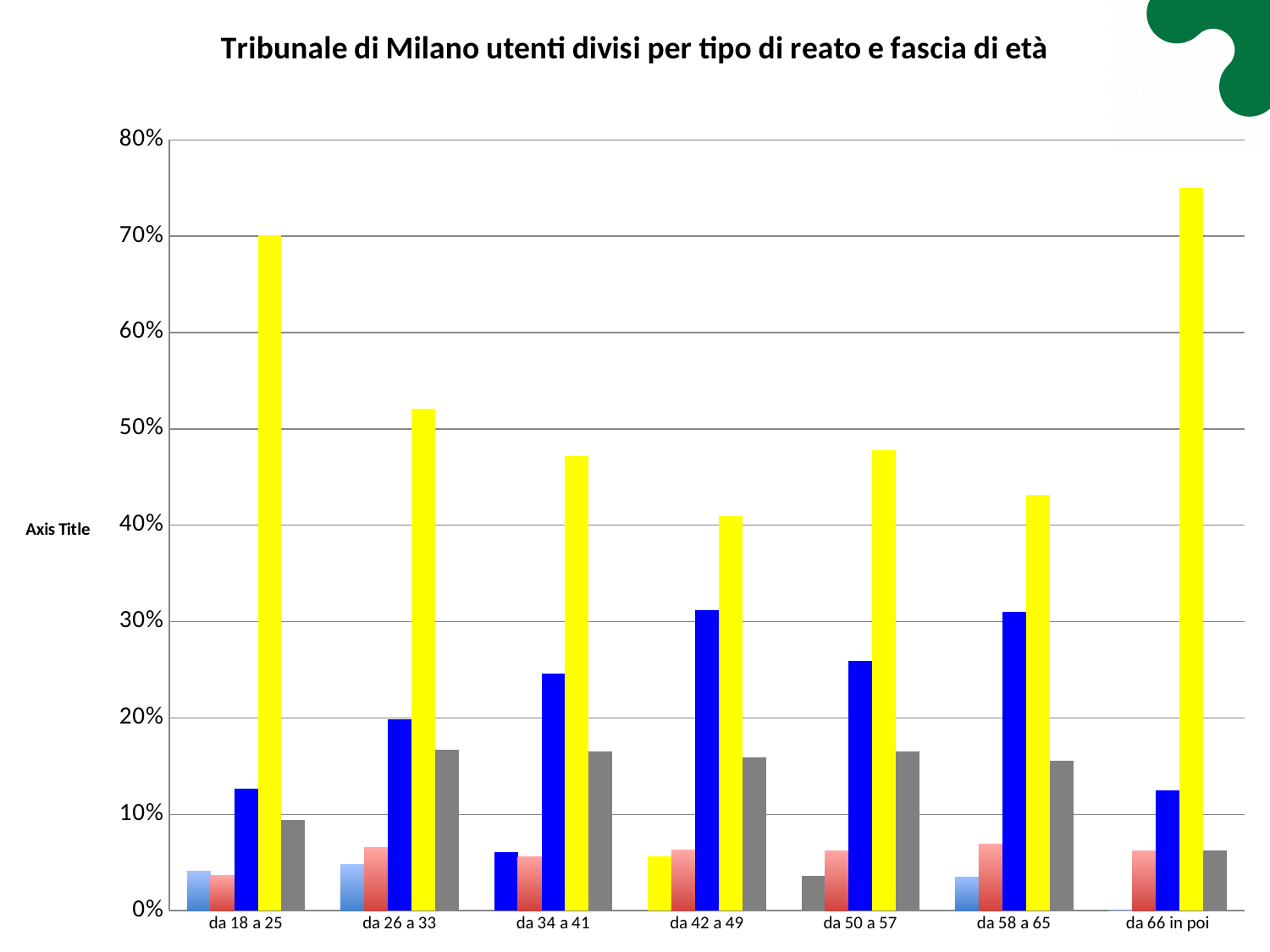
Which age group has the shortest yellow bar? da 42 a 49 Which is taller for 'da 50 a 57': the blue bar or the grey bar? the blue bar How many age-group categories are shown on the x axis? 7 Is the yellow bar for 'da 34 a 41' greater or less than 50%? less Is the yellow bar for 'da 26 a 33' greater or less than 50%? greater Which is taller: the yellow bar for 'da 18 a 25' or the yellow bar for 'da 58 a 65'? da 18 a 25 Which age group has the tallest yellow bar? da 66 in poi What kind of chart is shown on the slide? bar chart Is the blue bar for 'da 42 a 49' greater or less than 30%? greater What is the title of the chart? Tribunale di Milano utenti divisi per tipo di reato e fascia di età